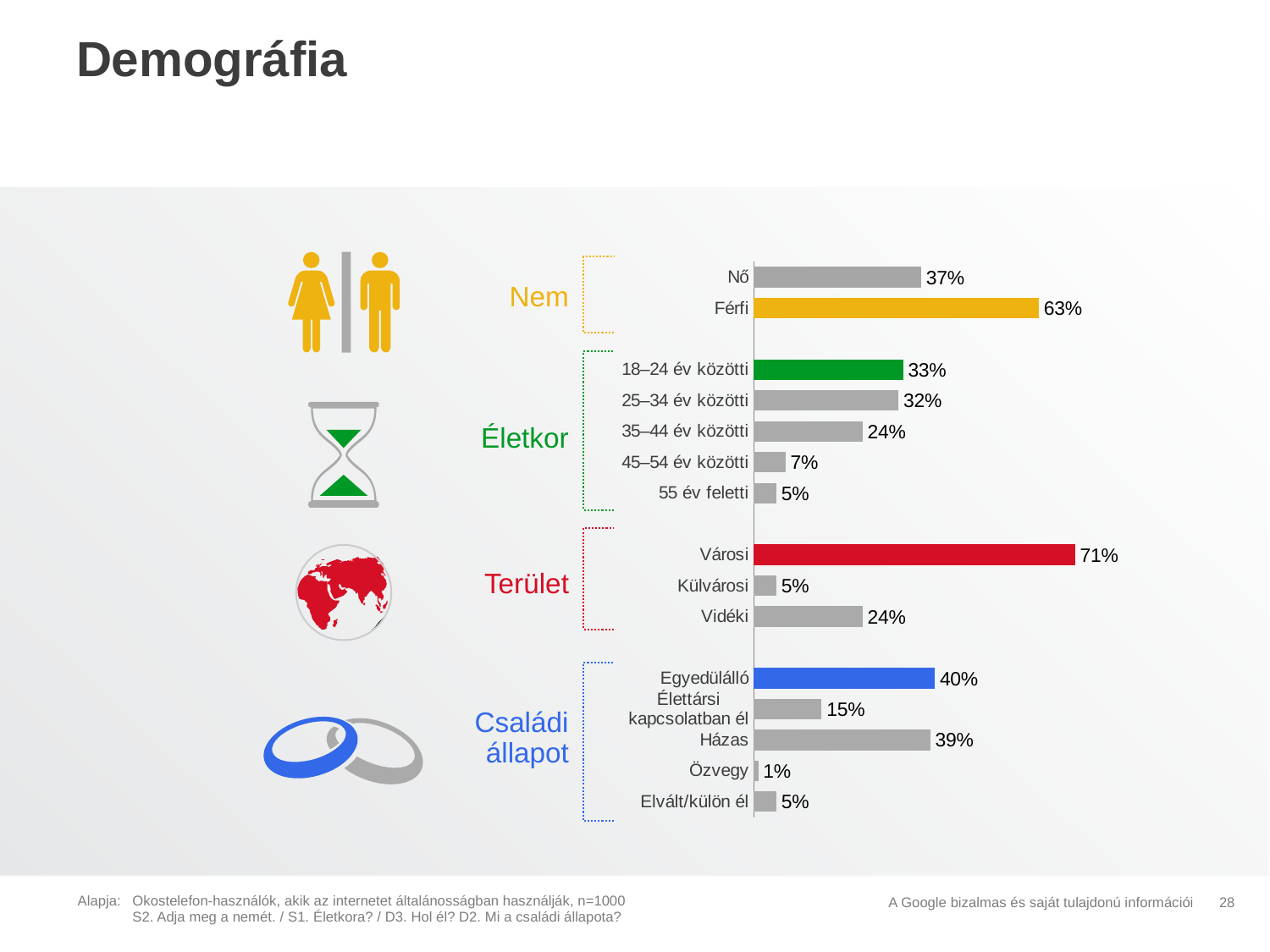
How many categories does the Családi állapot chart show? 5 In the Életkor chart, which age group has the highest value? 18–24 év közötti In the Életkor chart, which age group has the lowest value? 55 év feletti What kind of chart is used for the Terület data? Bar chart In the Életkor chart, what is the difference between the values for 18–24 év közötti and 45–54 év közötti? 26% In the Terület chart, what is the value for Városi? 71% In the Családi állapot chart, what is the value for Özvegy? 1% In the Életkor chart, what is the value for 35–44 év közötti? 24% In the Nem chart, what is the value for Nő? 37% In the Családi állapot chart, what is the difference between the values for Egyedülálló and Házas? 1% In the Terület chart, which is larger, Külvárosi or Vidéki? Vidéki In the Nem chart, what is the value for Férfi? 63%